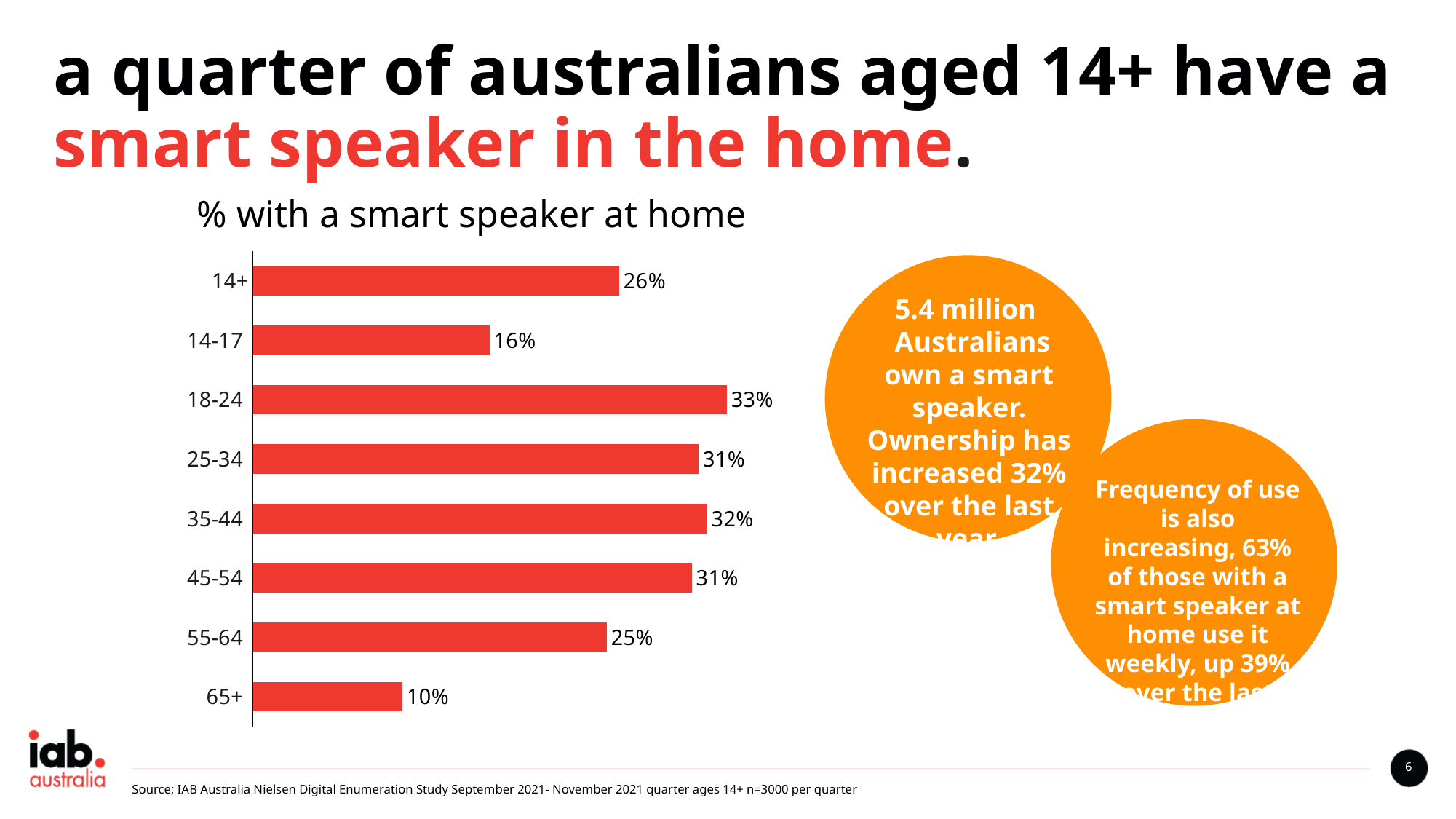
What is the title of the chart? % with a smart speaker at home What is the value for the 55-64 age group? 25% Which age group has the lowest percentage with a smart speaker at home? 65+ What percentage of Australians aged 14+ have a smart speaker at home? 26% How many age categories are shown in the chart? 8 Which age group has the highest percentage with a smart speaker at home? 18-24 What kind of chart is shown on the slide? Bar chart What is the difference between the 35-44 and 65+ age groups? 22 percentage points Which has a higher value, the 14-17 age group or the 55-64 age group? 55-64 What is the value for the 18-24 age group? 33% What is the value for the 65+ age group? 10% What is the difference between the 18-24 and 14-17 age groups? 17 percentage points